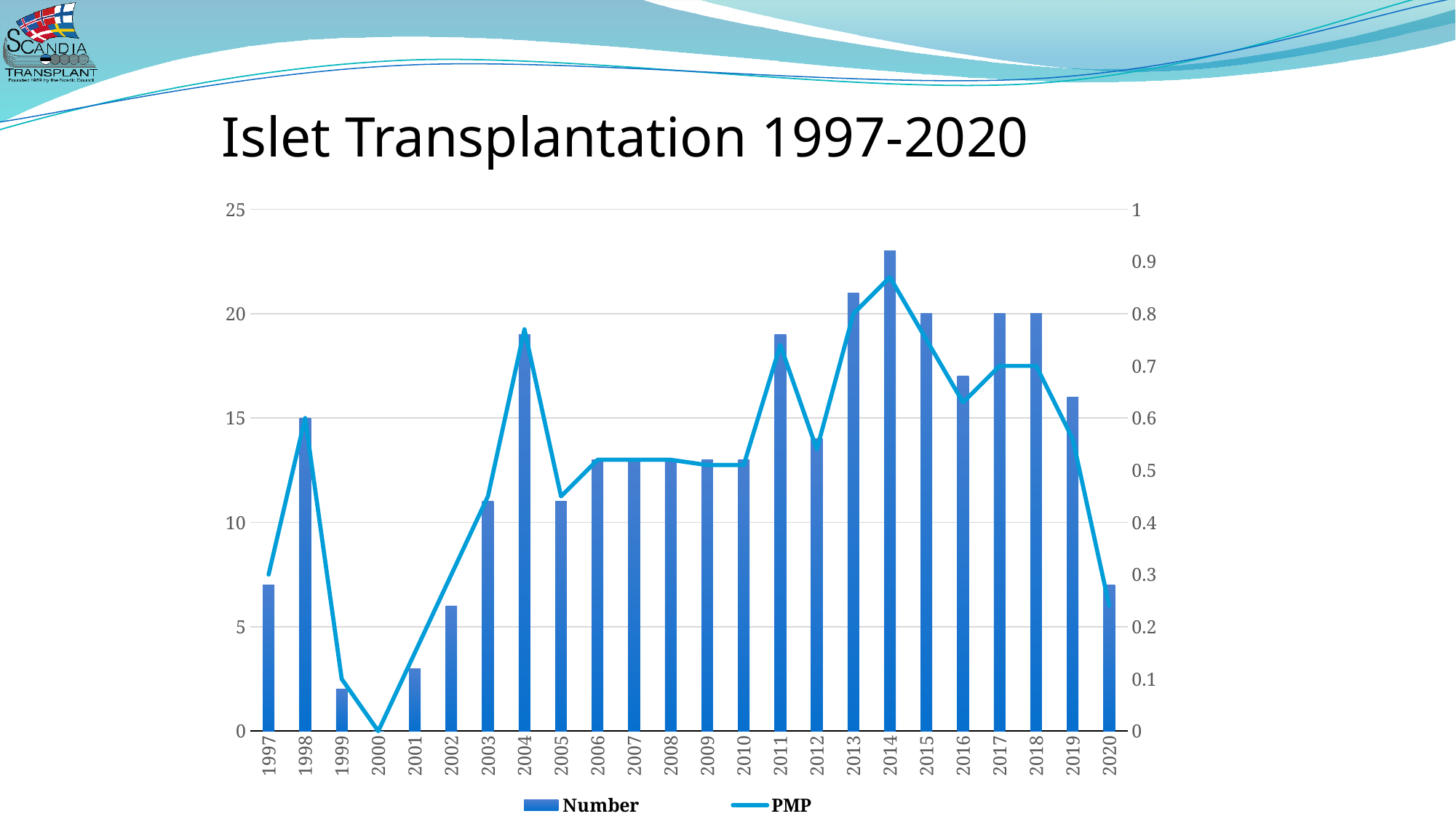
Is the Number value for 2004 greater or less than 15? greater What is the difference between the Number values for 2015 and 1998? 5 Do the Number values rise or fall from 2018 to 2020? fall How many years are shown on the x axis? 24 What is the Number value for 2015? 20 Is the PMP value for 2014 greater or less than 0.8? greater What is the Number value for 1998? 15 What is the Number value for 2000? 0 Which year has the lowest Number bar? 2000 Which year has the highest Number bar? 2014 How many series does the legend list? 2 Which year has a larger Number value, 2013 or 2014? 2014